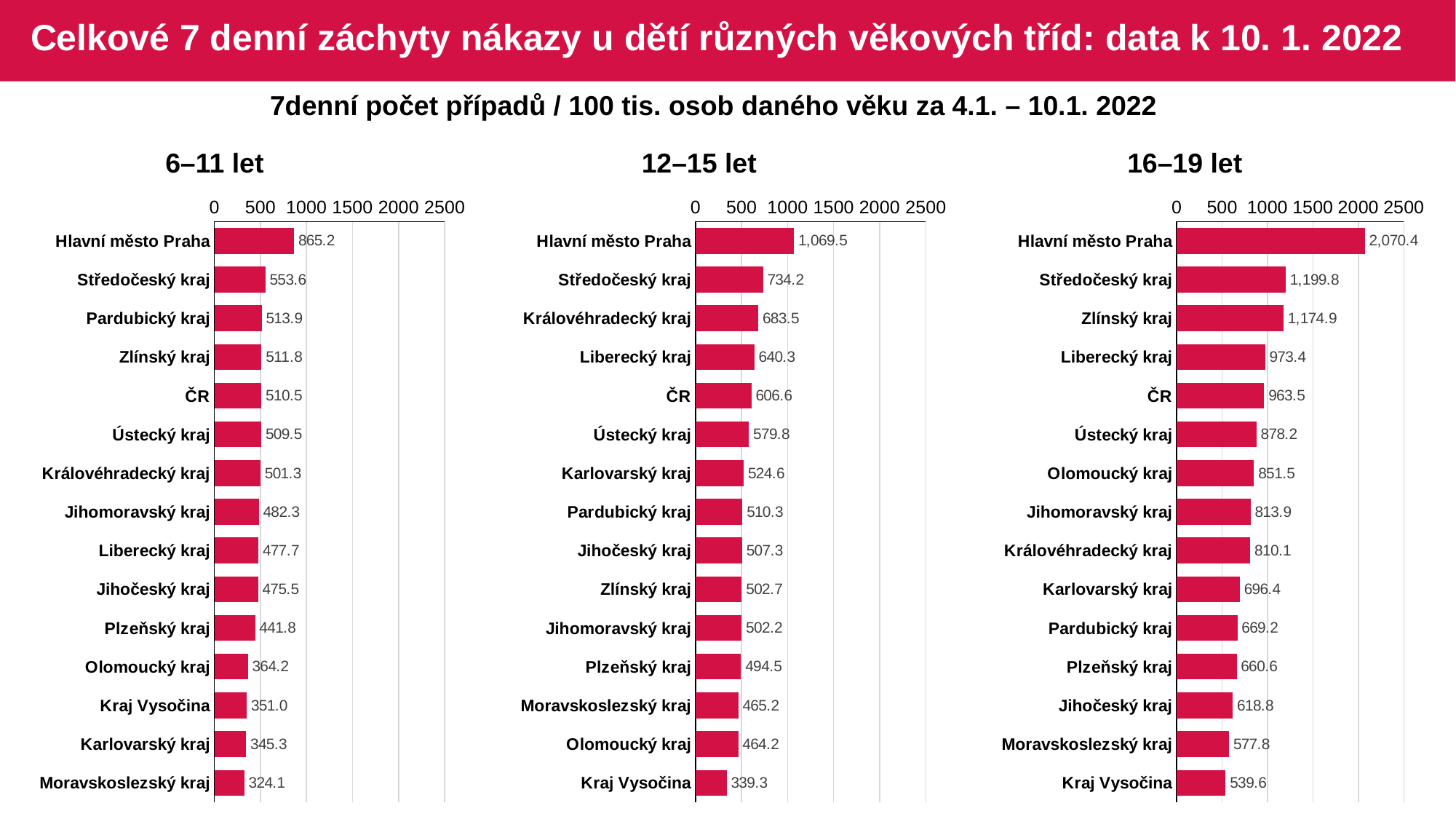
In the "16–19 let" chart, is the value for Hlavní město Praha greater or less than 2000? greater In the "6–11 let" chart, which category has the lowest value? Moravskoslezský kraj In the "6–11 let" chart, what is the value for Hlavní město Praha? 865.2 What kind of chart is the "6–11 let" chart? bar chart In the "16–19 let" chart, what is the difference between Hlavní město Praha and Středočeský kraj? 870.6 In the "12–15 let" chart, which category has the lowest value? Kraj Vysočina In the "16–19 let" chart, which category has the highest value? Hlavní město Praha In the "12–15 let" chart, what is the value for ČR? 606.6 In the "16–19 let" chart, what is the value for Zlínský kraj? 1,174.9 In the "6–11 let" chart, what is the difference between Hlavní město Praha and Moravskoslezský kraj? 541.1 In the "12–15 let" chart, which is larger: Středočeský kraj or Liberecký kraj? Středočeský kraj How many categories are shown in the "12–15 let" chart? 15